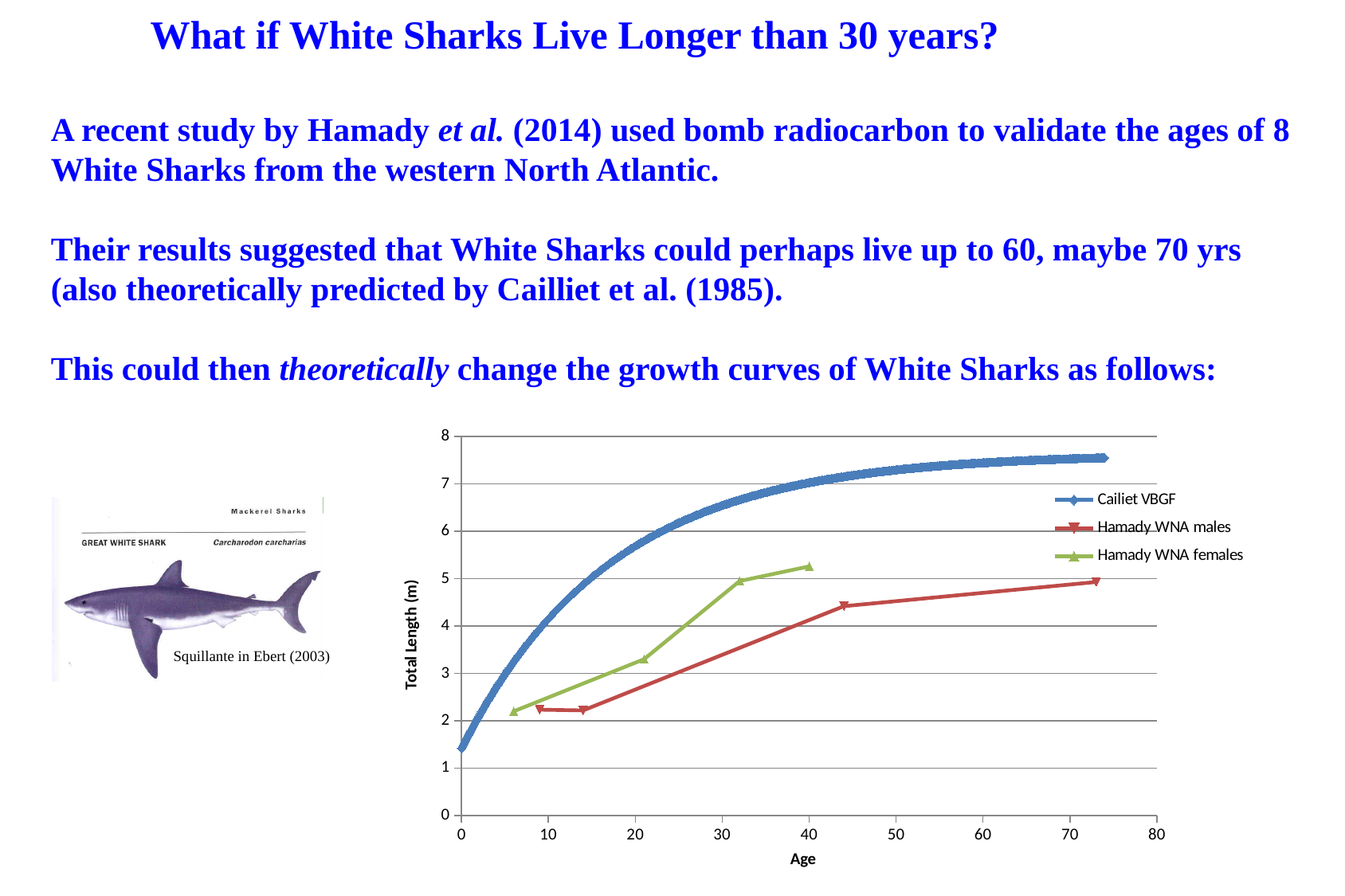
Which series reaches the highest total length on the chart? Cailiet VBGF Is the total length for Cailiet VBGF at age 70 greater or less than 7? greater At age 32, which series shows a larger total length: Hamady WNA females or Hamady WNA males? Hamady WNA females Does the Cailiet VBGF curve rise or fall as age increases? rise What is the label of the chart's y axis? Total Length (m) What are the three series named in the chart legend? Cailiet VBGF, Hamady WNA males, Hamady WNA females Is the total length for Hamady WNA males at age 44 greater or less than 5? less What kind of chart is shown on the slide? line chart How many series does the chart legend list? 3 Is the total length for Hamady WNA females at age 40 greater or less than 5? greater How many data points are plotted for the Hamady WNA males series? 4 How many data points are plotted for the Hamady WNA females series? 4